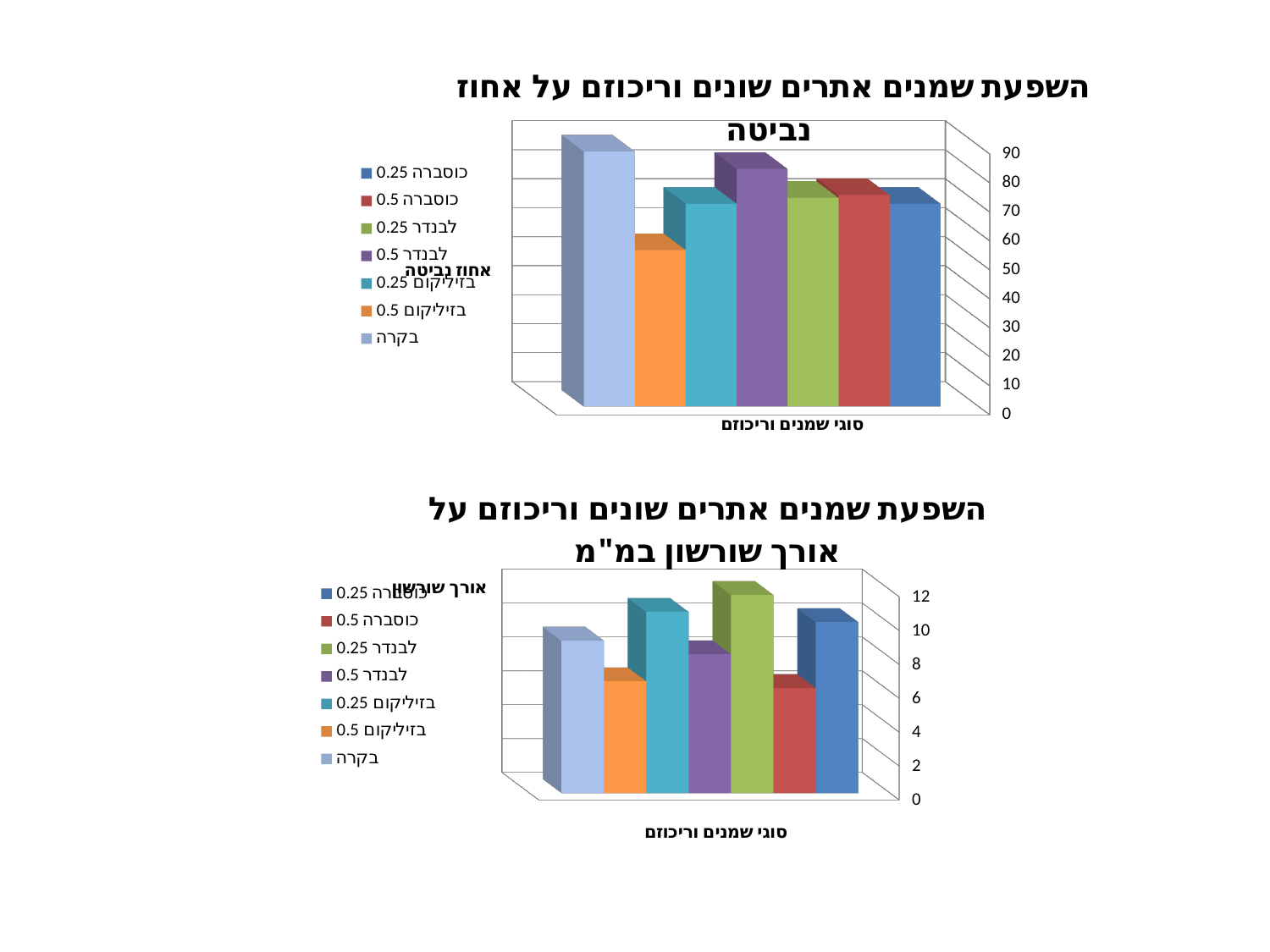
What is the x-axis title of the top chart? סוגי שמנים וריכוזם What kind of chart is the top chart on the slide? bar chart In the top chart (אחוז נביטה), which series has the highest value? בקרה In the bottom chart (אורך שורשון במ"מ), which series has the highest value? לבנדר 0.25 In the top chart (אחוז נביטה), which series has the lowest value? בזיליקום 0.5 In the bottom chart (אורך שורשון במ"מ), which is larger: the value for בזיליקום 0.25 or the value for בזיליקום 0.5? בזיליקום 0.25 In the top chart (אחוז נביטה), which is larger: the value for בקרה or the value for בזיליקום 0.5? בקרה In the top chart (אחוז נביטה), is the value for בזיליקום 0.5 greater or less than 60? less In the bottom chart (אורך שורשון במ"מ), is the value for לבנדר 0.25 greater or less than 10? greater In the bottom chart (אורך שורשון במ"מ), is the value for כוסברה 0.5 greater or less than 8? less How many series does the legend of the top chart list? 7